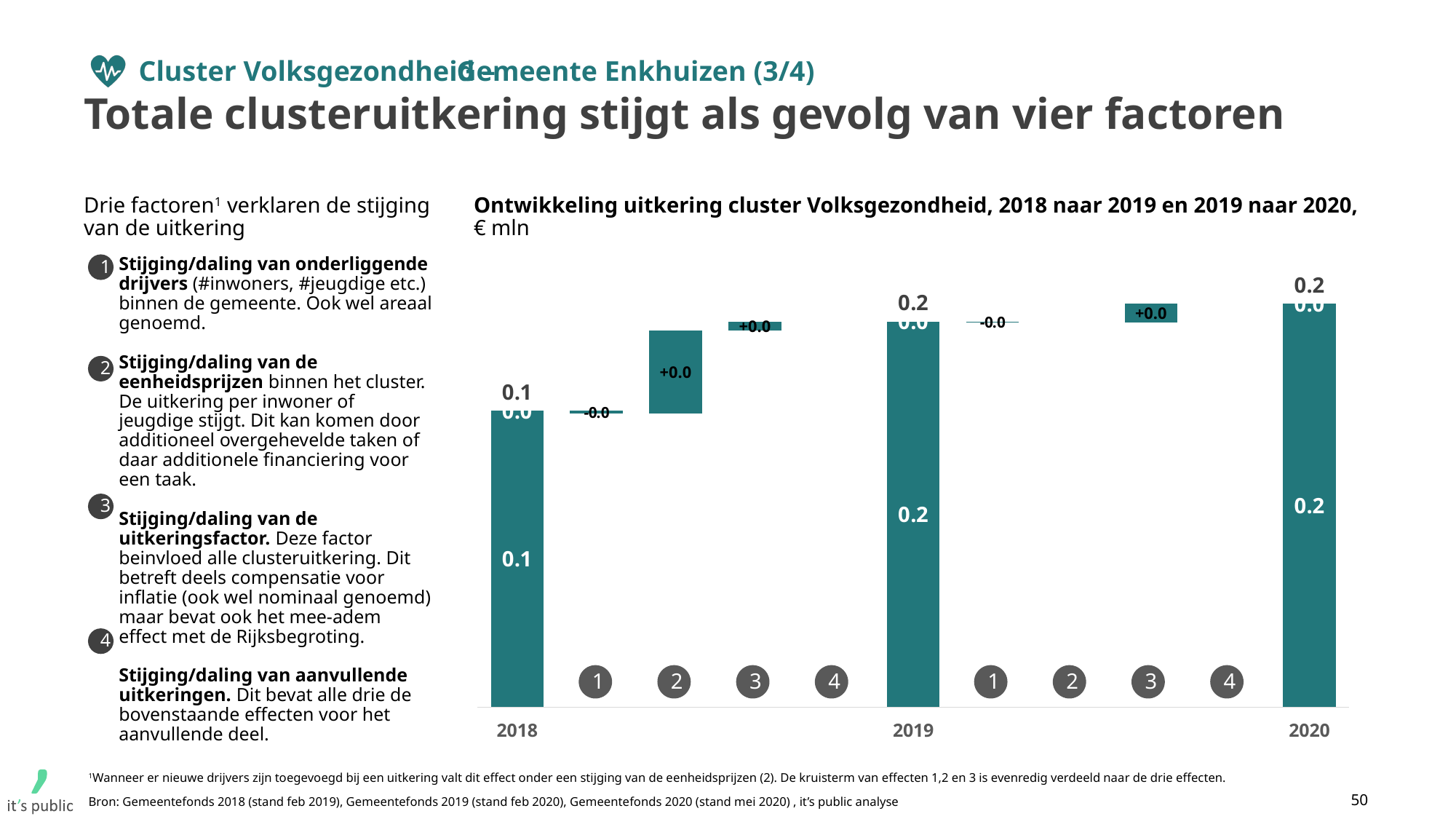
What is the total uitkering shown for 2020? 0.2 What is the total uitkering shown for 2018? 0.1 In what unit are the chart values expressed? € mln What kind of chart is shown on the slide? bar chart Do the year totals rise or fall from 2018 to 2020? rise What is the difference between the 2020 total and the 2019 total? 0.0 Which year has the lowest total uitkering? 2018 What is the difference between the 2019 total and the 2018 total? 0.1 What is the value labelled on factor 2 between 2018 and 2019? +0.0 Which is larger, the total for 2018 or the total for 2019? 2019 How many year totals are shown in the chart? 3 What is the total uitkering shown for 2019? 0.2